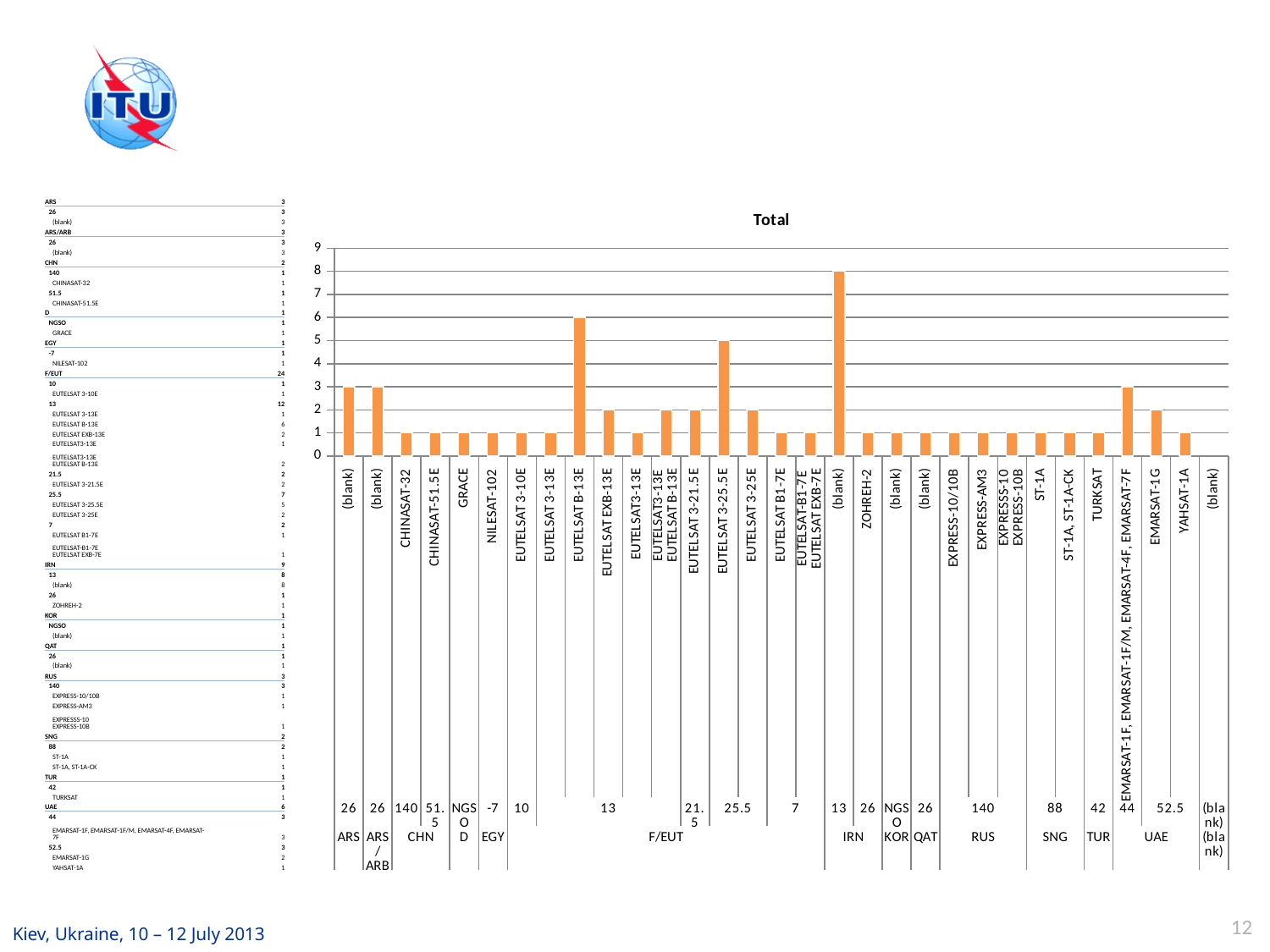
What is the value for TURKSAT? 1 What kind of chart is shown on the slide? bar chart What is the value for ZOHREH-2? 1 What is the title of the chart? Total What is the highest value reached by any bar in the chart? 8 Is the value for the (blank) category under IRN greater or less than 7? greater What is the difference between the value for EUTELSAT B-13E and the value for EUTELSAT EXB-13E? 4 What is the value for EUTELSAT B-13E? 6 Which is larger, the value for EUTELSAT B-13E or the value for EUTELSAT 3-25.5E? EUTELSAT B-13E What is the value for EUTELSAT 3-25.5E? 5 What is the value for EMARSAT-1G? 2 Which named satellite category has the tallest bar? EUTELSAT B-13E